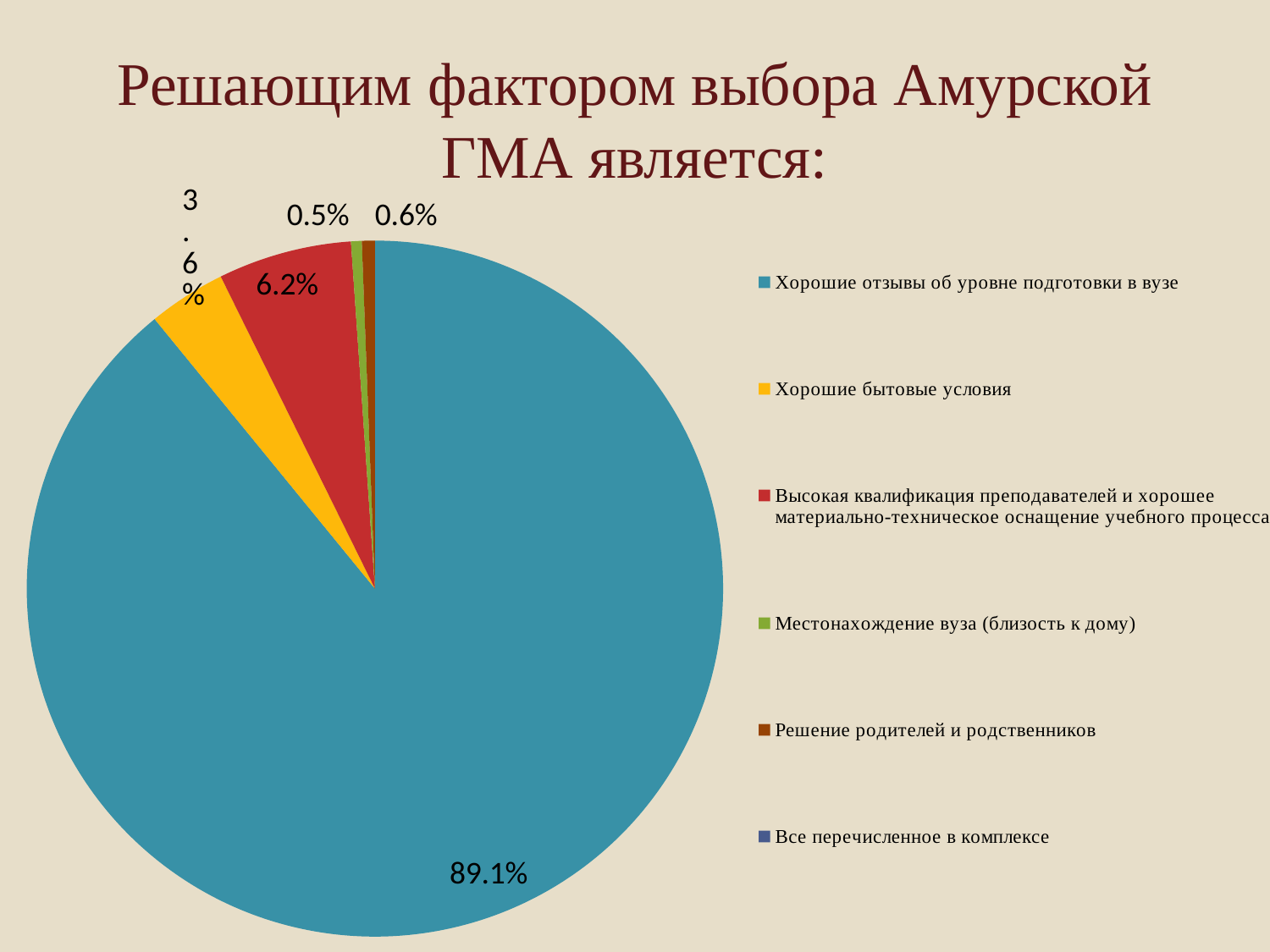
Which has a larger share: "Хорошие бытовые условия" or "Высокая квалификация преподавателей и хорошее материально-техническое оснащение учебного процесса"? Высокая квалификация преподавателей и хорошее материально-техническое оснащение учебного процесса By how many percentage points does "Хорошие отзывы об уровне подготовки в вузе" exceed "Высокая квалификация преподавателей и хорошее материально-техническое оснащение учебного процесса"? 82.9 percentage points What colour is the slice for "Хорошие отзывы об уровне подготовки в вузе"? Blue What is the difference between the shares for "Высокая квалификация преподавателей..." (6.2%) and "Хорошие бытовые условия" (3.6%)? 2.6 percentage points What percentage is shown for "Высокая квалификация преподавателей и хорошее материально-техническое оснащение учебного процесса"? 6.2% What percentage is shown for "Решение родителей и родственников"? 0.6% What percentage of the pie is labelled for "Хорошие отзывы об уровне подготовки в вузе"? 89.1% What type of chart is shown on the slide? Pie chart How many entries does the legend list? 6 Which factor has the largest share of the pie? Хорошие отзывы об уровне подготовки в вузе What percentage is shown for "Хорошие бытовые условия"? 3.6% What percentage is shown for "Местонахождение вуза (близость к дому)"? 0.5%